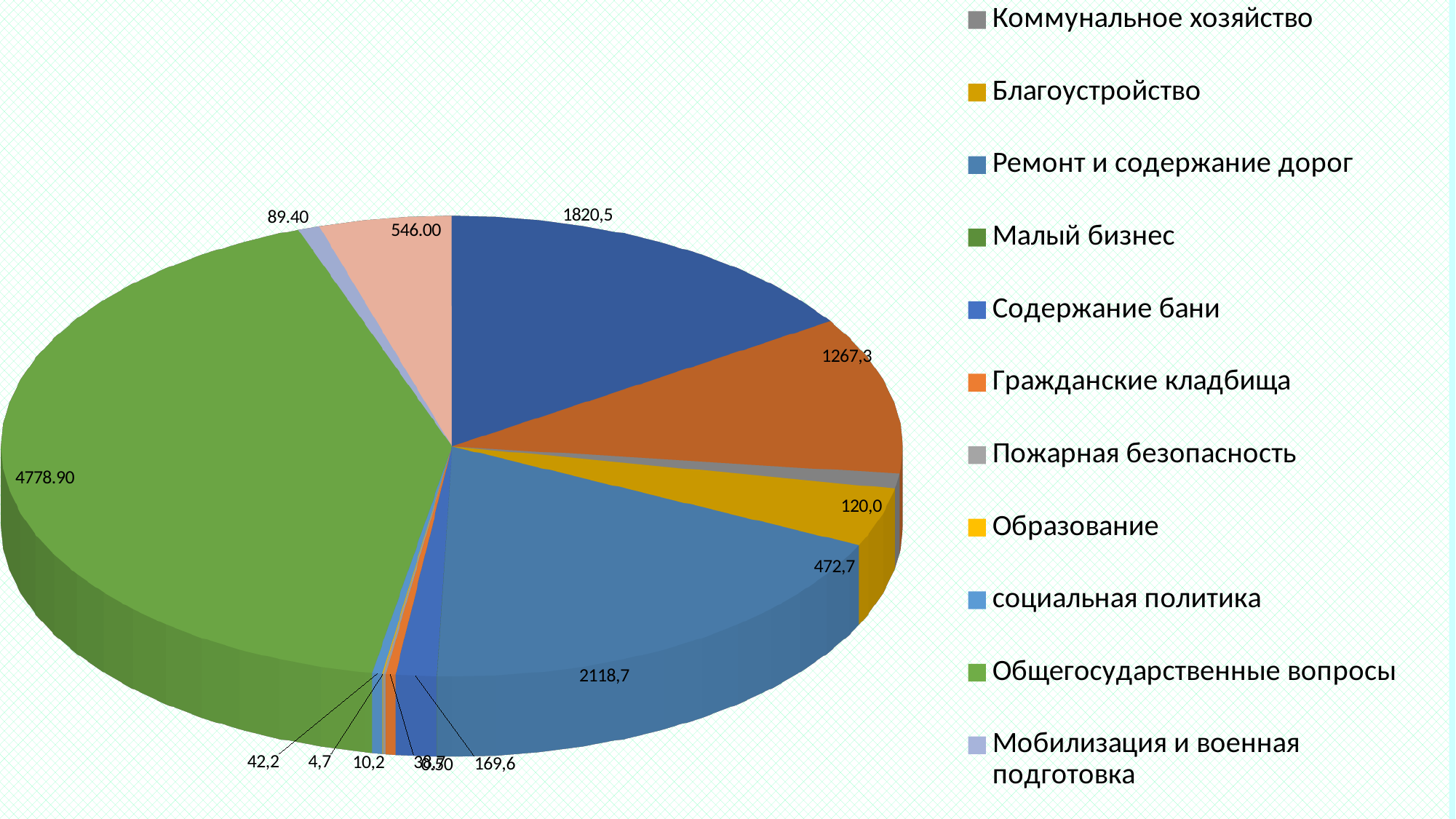
What type of chart is shown on the slide? pie chart What value is labelled on the largest slice of the pie? 4778.90 What is the smallest value labelled on the pie chart? 0,50 What is the first entry listed in the legend? Коммунальное хозяйство How many entries does the legend list? 11 Which is larger, the slice labelled 546.00 or the slice labelled 472,7? 546.00 What is the difference between the slices labelled 546.00 and 89.40? 456.60 Which is larger, the slice labelled 1820,5 or the slice labelled 1267,3? 1820,5 What is the difference between the slices labelled 2118,7 and 1820,5? 298,2 What colour is the largest slice of the pie? green What is the difference between the slices labelled 1820,5 and 1267,3? 553,2